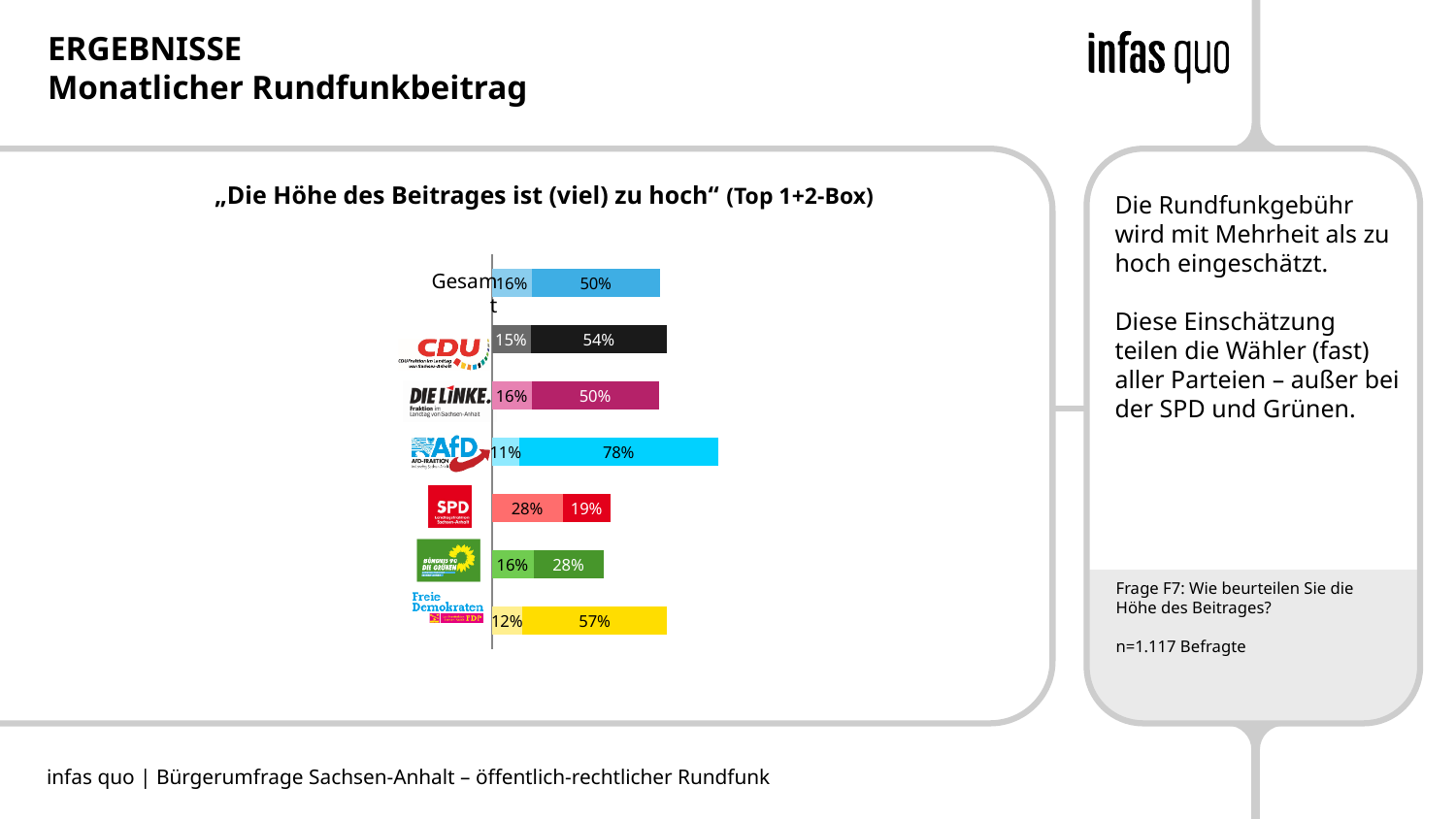
What is the total of the two segments for AfD? 89% What type of chart is shown on the slide? stacked bar chart Which category has the largest right (darker) segment? AfD How many categories (rows) does the chart show? 7 What is the difference between the right segment for FDP and the right segment for Grüne? 29% What is the total of the two segments for SPD? 47% What is the value of the right segment for Gesamt? 50% Which is larger: the right segment for CDU or the right segment for DIE LINKE? CDU What is the value of the left segment for CDU? 15% Which category has the smallest right (darker) segment? SPD What is the value of the left (lighter) segment for SPD? 28% What is the value of the right (darker) segment for AfD? 78%